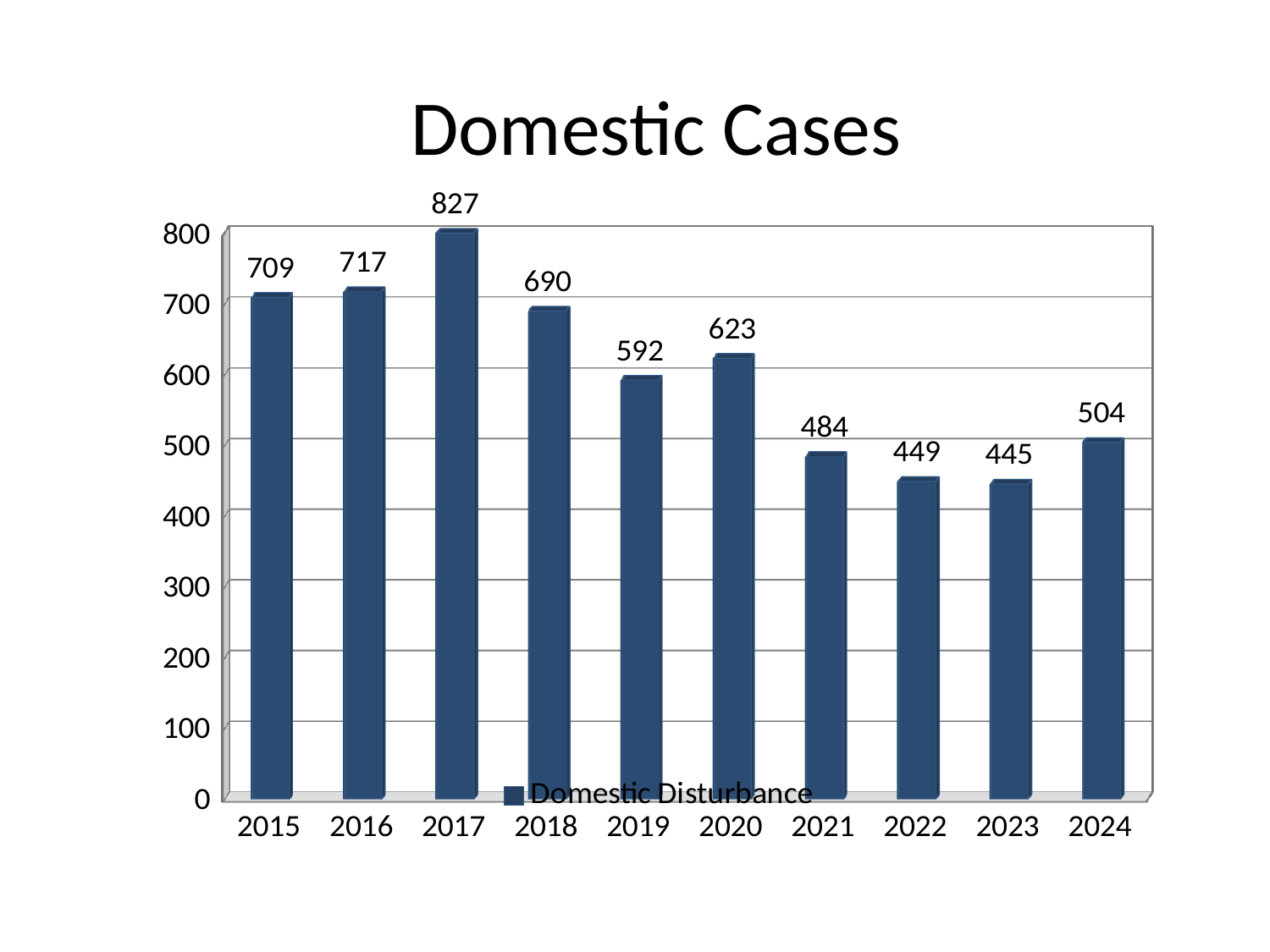
Which is larger, the value for 2019 or the value for 2020? 2020 How many years are shown on the x axis? 10 What kind of chart is shown? bar chart What is the title of the chart? Domestic Cases Is the value for 2021 greater or less than 500? less What is the value for 2017? 827 What is the difference between the values for 2017 and 2018? 137 What is the difference between the values for 2024 and 2023? 59 What is the value for 2020? 623 What is the value for 2023? 445 Which year has the highest value? 2017 Which year has the lowest value? 2023